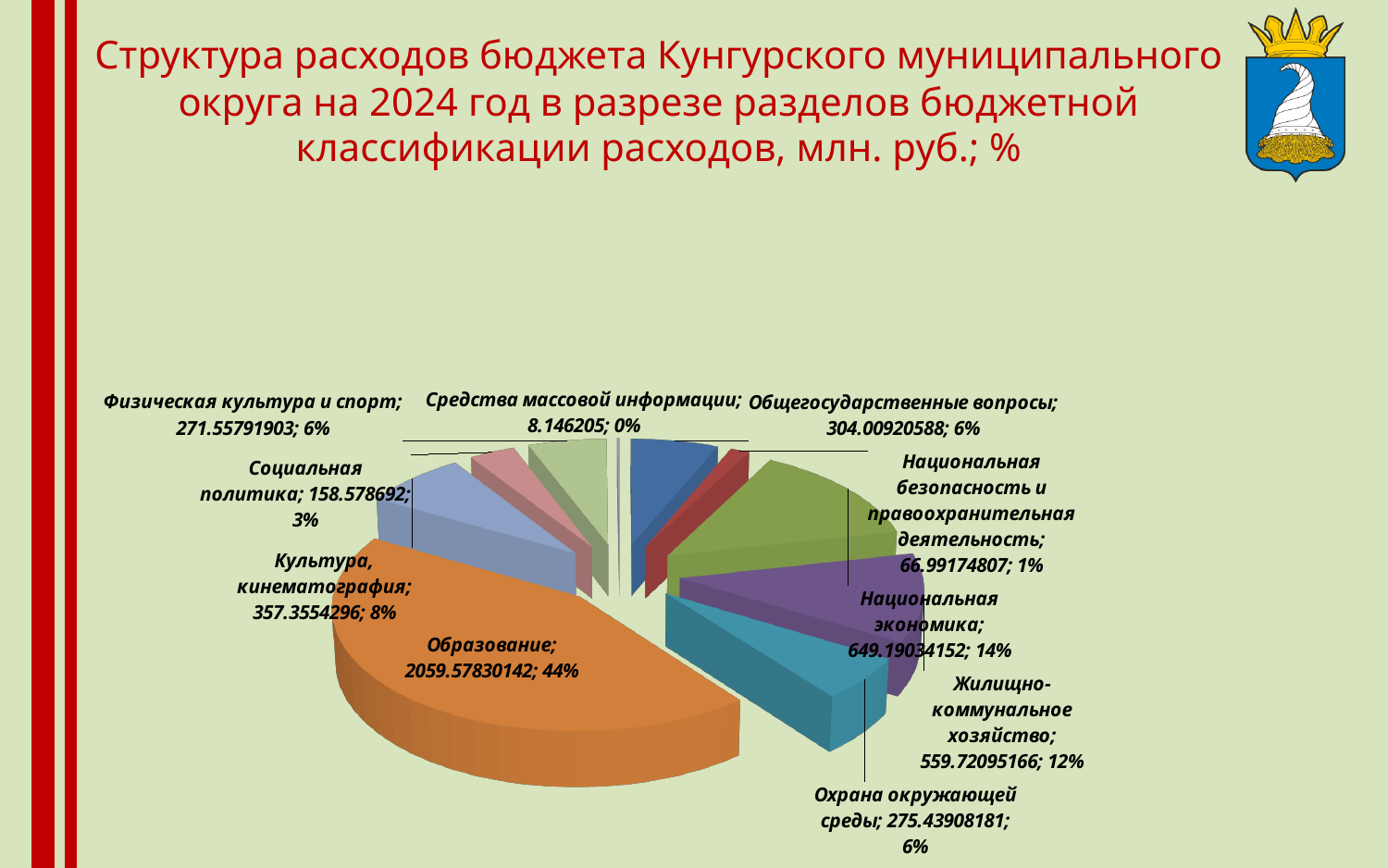
What is the value for Средства массовой информации? 8.146205 Which category has the smallest slice of the pie? Средства массовой информации What is the value for Социальная политика? 158.578692 What share of the pie does Культура, кинематография represent? 8% What share of the pie does Жилищно-коммунальное хозяйство represent? 12% What share of the pie does Образование represent? 44% Which is larger, Национальная экономика or Жилищно-коммунальное хозяйство? Национальная экономика What kind of chart is shown on the slide? pie chart Which category has the largest slice of the pie? Образование What is the value for Национальная экономика? 649.19034152 What is the value for Образование? 2059.57830142 How many categories (slices) does the pie chart show? 10